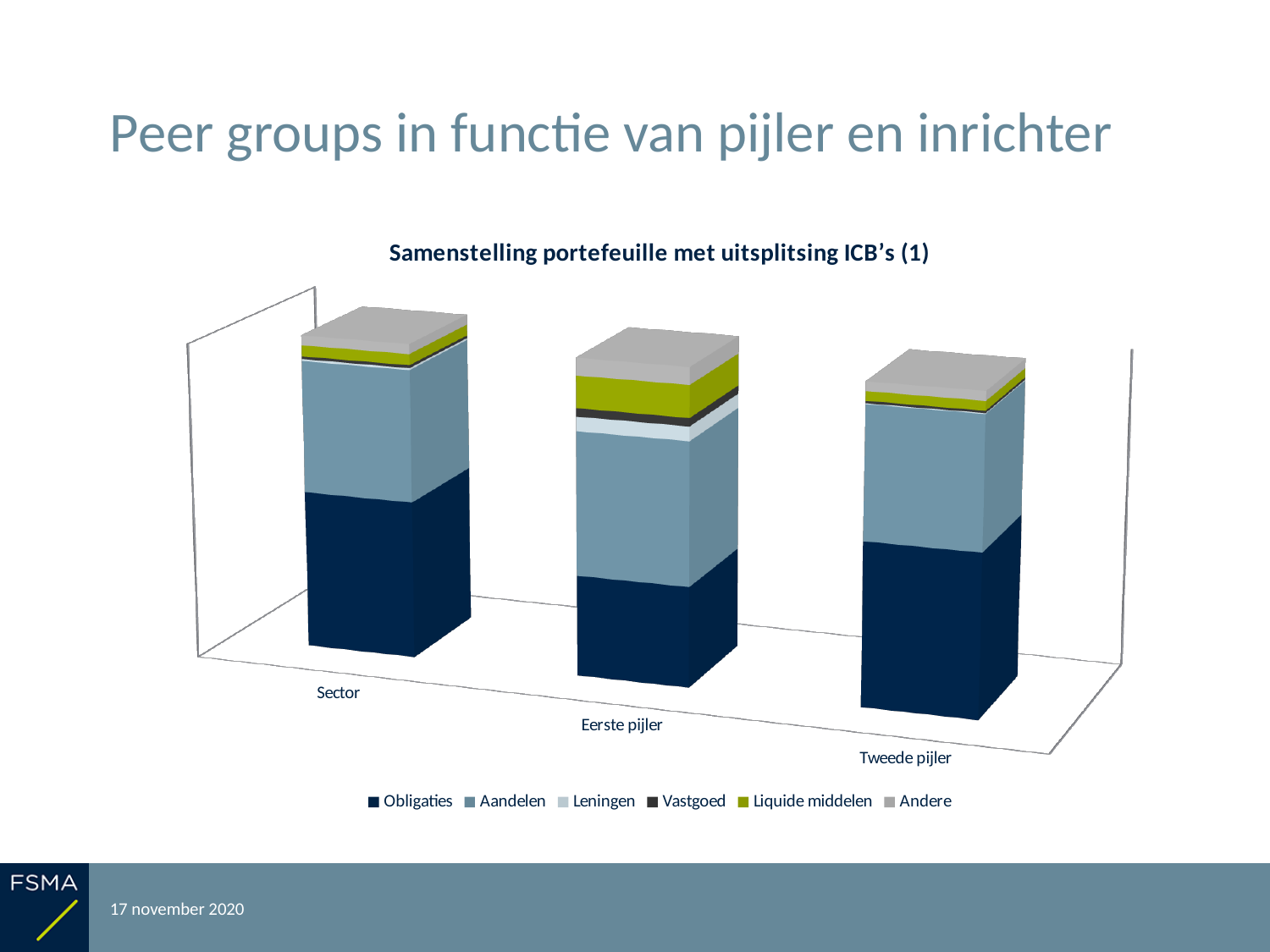
How many series does the chart's legend list? 6 Is the Obligaties segment larger for Sector or for Eerste pijler? Sector Which category is shown in the middle of the x axis? Eerste pijler Which category has the largest Liquide middelen segment? Eerste pijler Which category has the smallest Obligaties segment? Eerste pijler What kind of chart is shown on the slide? Stacked bar chart How many categories are shown on the x axis of the chart? 3 Which category has the largest Leningen segment? Eerste pijler Is the Liquide middelen segment larger for Eerste pijler or for Tweede pijler? Eerste pijler What is the title of the chart? Samenstelling portefeuille met uitsplitsing ICB's (1) Which series is listed first in the chart's legend? Obligaties Is the Obligaties segment larger for Tweede pijler or for Eerste pijler? Tweede pijler